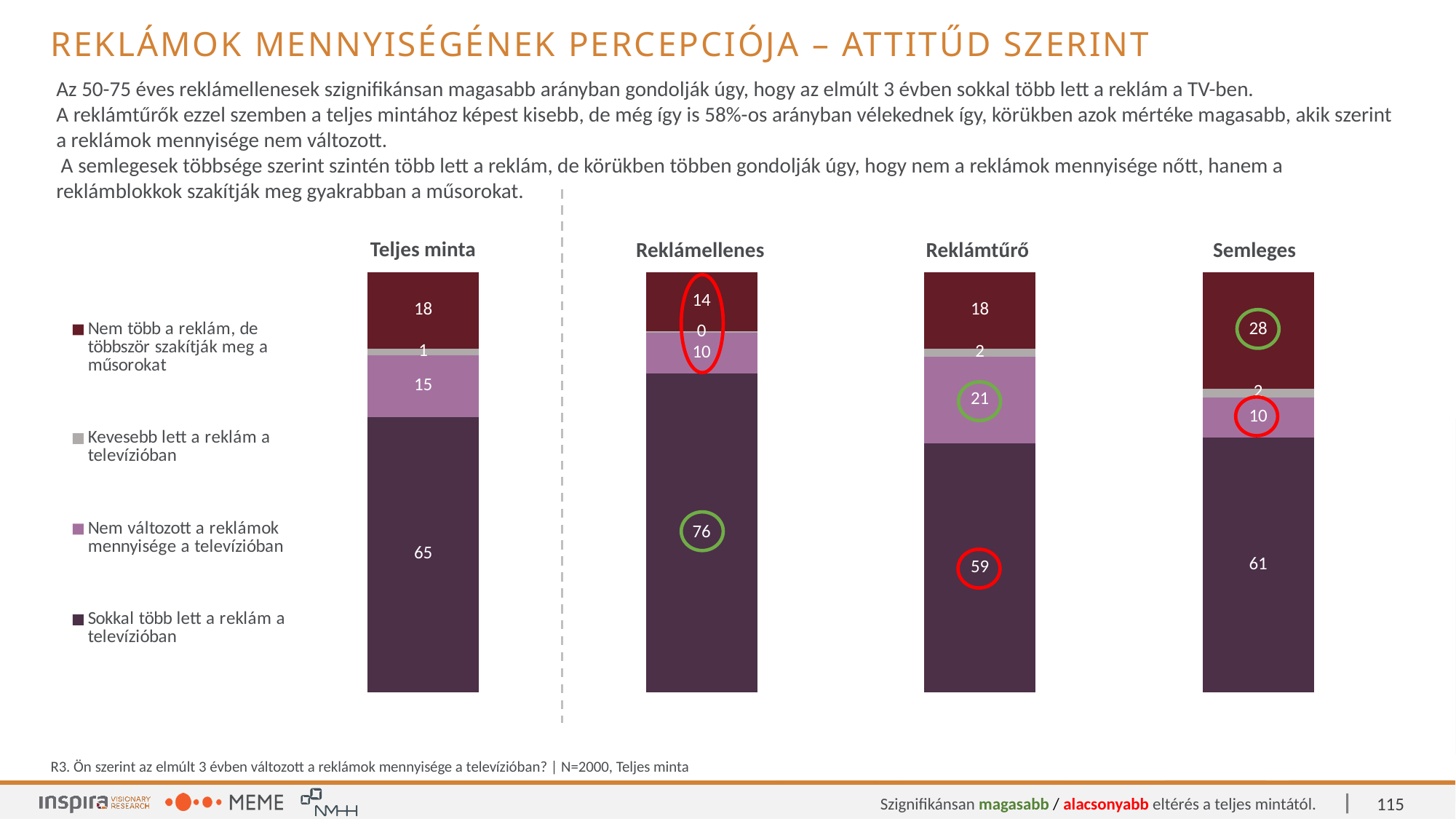
What is the value for 'Sokkal több lett a reklám a televízióban' in the Reklámellenes bar? 76 How many bars (groups) are shown in the chart? 4 What is the value for 'Nem változott a reklámok mennyisége a televízióban' in the Reklámtűrő bar? 21 What is the difference between the 'Sokkal több lett a reklám a televízióban' values for Reklámellenes and Reklámtűrő? 17 Which group has the highest value for 'Sokkal több lett a reklám a televízióban'? Reklámellenes How many series does the legend list? 4 What is the value for 'Kevesebb lett a reklám a televízióban' in the Teljes minta bar? 1 What kind of chart is shown on the slide? Stacked bar chart Which group has the lowest value for 'Sokkal több lett a reklám a televízióban'? Reklámtűrő Which is larger: the 'Nem több a reklám, de többször szakítják meg a műsorokat' value for Semleges or for Teljes minta? Semleges What is the value for 'Nem több a reklám, de többször szakítják meg a műsorokat' in the Semleges bar? 28 Which series is shown in the darkest purple colour at the bottom of each bar? Sokkal több lett a reklám a televízióban